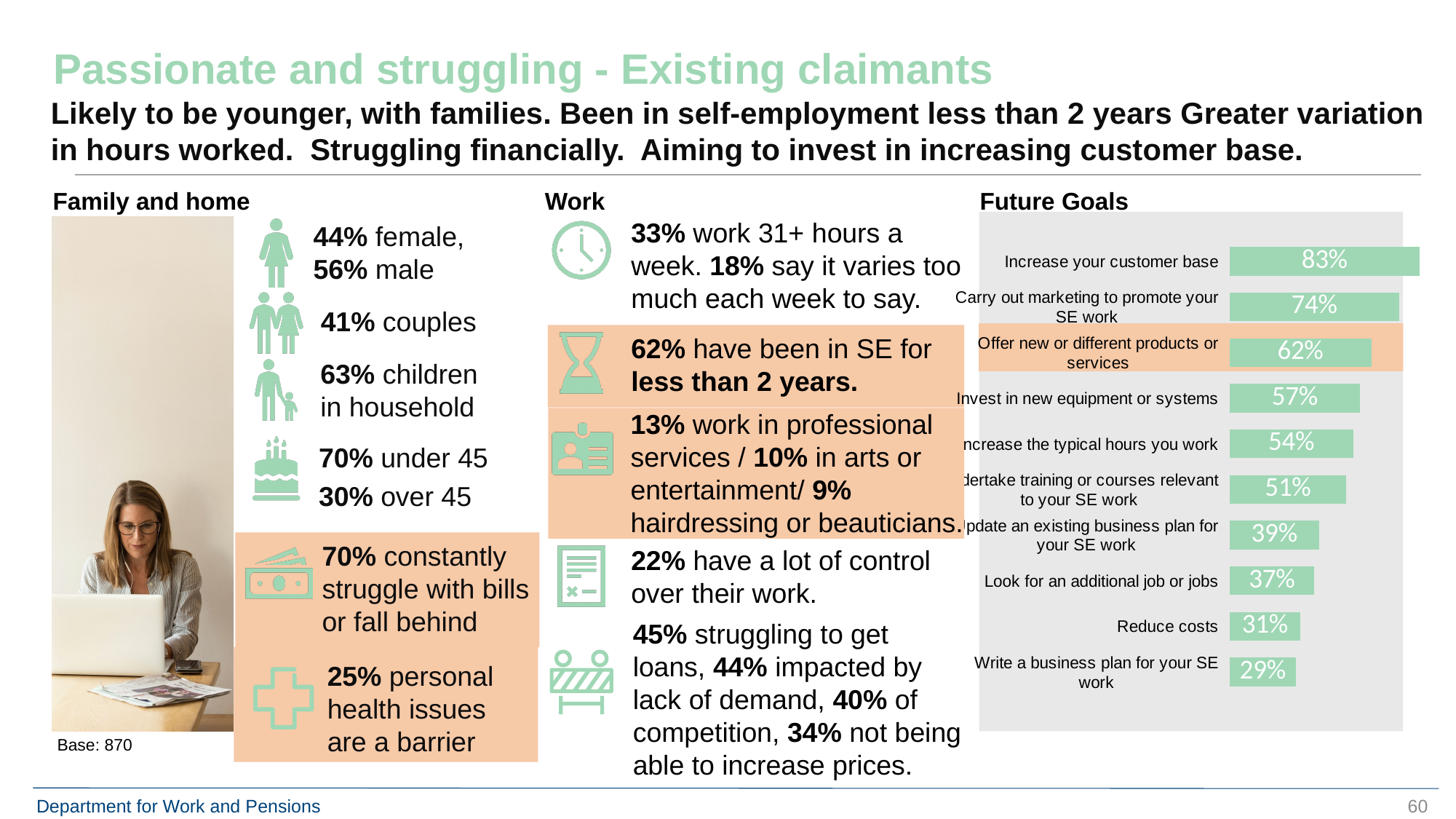
In the Future Goals chart, what is the difference between 'Offer new or different products or services' and 'Reduce costs'? 31% In the Future Goals chart, what percentage is shown for 'Look for an additional job or jobs'? 37% In the Future Goals chart, which goal has the highest percentage? Increase your customer base In the Future Goals chart, which goal has the lowest percentage? Write a business plan for your SE work In the Future Goals chart, which bar is highlighted with an orange background? Offer new or different products or services In the Future Goals chart, which is larger: 'Invest in new equipment or systems' or 'Look for an additional job or jobs'? Invest in new equipment or systems In the Future Goals chart, what percentage is shown for 'Increase your customer base'? 83% What type of chart is the Future Goals chart? Bar chart In the Future Goals chart, what percentage is shown for 'Reduce costs'? 31% In the Future Goals chart, what is the difference between 'Increase your customer base' and 'Carry out marketing to promote your SE work'? 9% How many goals are listed in the Future Goals chart? 10 In the Future Goals chart, what percentage is shown for 'Invest in new equipment or systems'? 57%